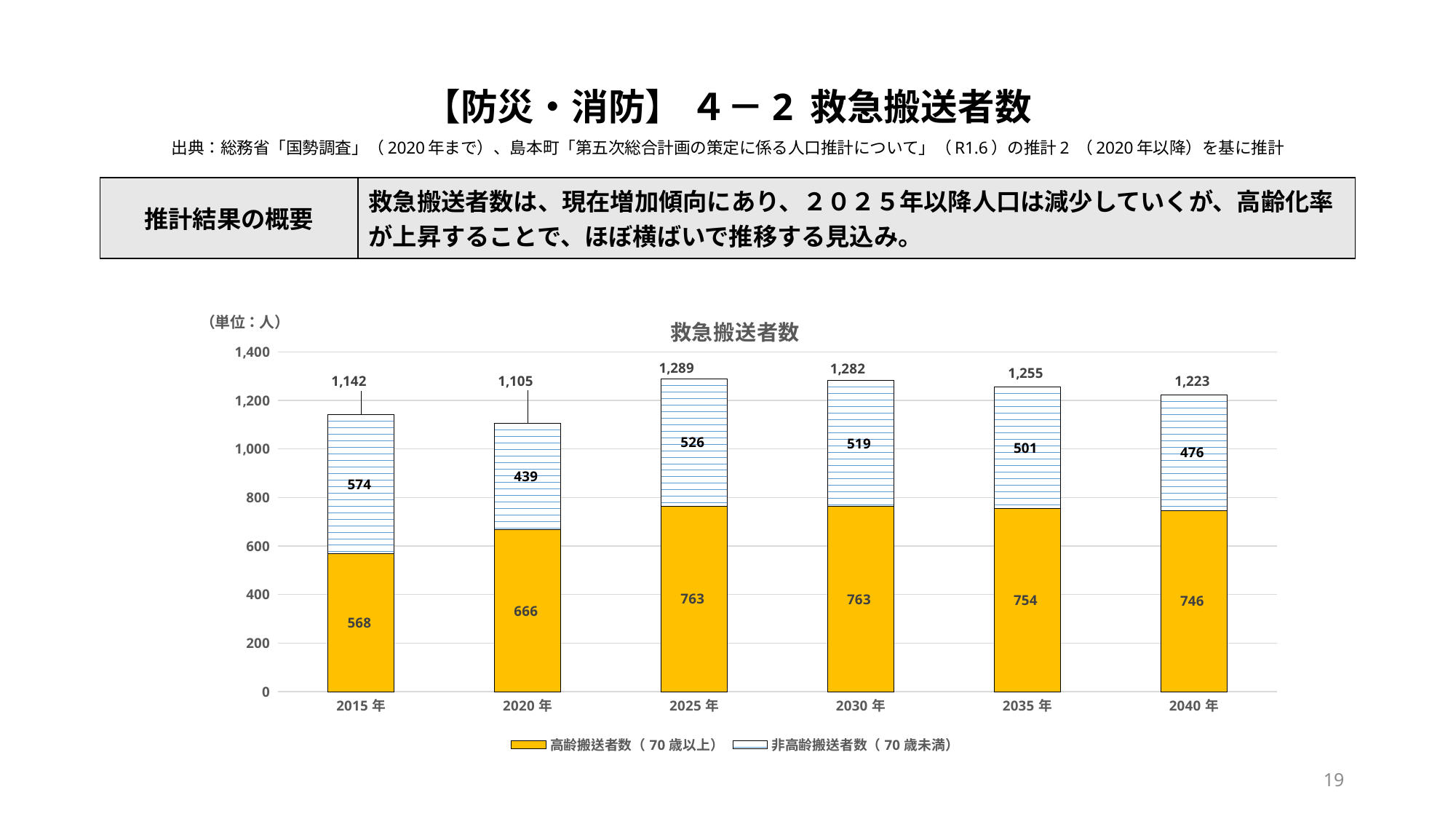
What is the title of the chart? 救急搬送者数 Which is larger, the 高齢搬送者数（70歳以上） value for 2035年 or for 2040年? 2035年 What is the total of the stacked bar for 2025年? 1,289 How many series does the legend list? 2 Which year has the lowest total 救急搬送者数? 2020年 How many years are shown on the x axis? 6 What kind of chart is shown? Stacked bar chart What is the value for 高齢搬送者数（70歳以上） in 2015年? 568 Does the 非高齢搬送者数（70歳未満） value rise or fall from 2025年 to 2040年? Fall Which year has the highest total 救急搬送者数? 2025年 What is the value for 非高齢搬送者数（70歳未満） in 2040年? 476 What is the difference between the 非高齢搬送者数（70歳未満） values for 2015年 and 2020年? 135